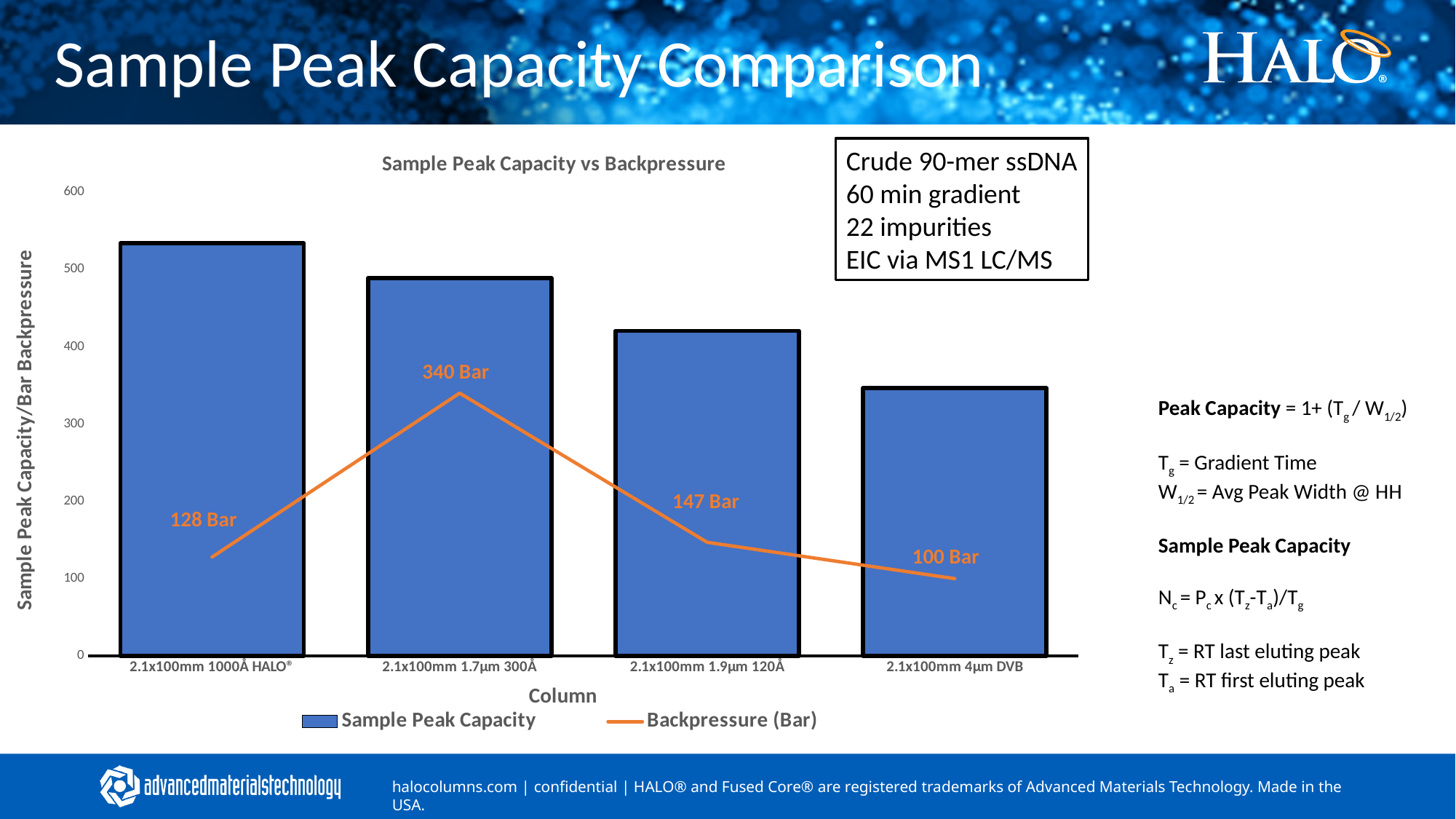
How many series does the chart legend list? 2 Which column has the highest backpressure? 2.1x100mm 1.7µm 300Å Which column has the highest sample peak capacity? 2.1x100mm 1000Å HALO What is the backpressure for the 2.1x100mm 1000Å HALO column? 128 Bar Is the sample peak capacity for the 2.1x100mm 1000Å HALO column greater or less than 500? greater What is the backpressure for the 2.1x100mm 4µm DVB column? 100 Bar Which column has the lowest sample peak capacity? 2.1x100mm 4µm DVB What is the backpressure for the 2.1x100mm 1.7µm 300Å column? 340 Bar How many columns are compared on the x axis of the chart? 4 Is the sample peak capacity for the 2.1x100mm 4µm DVB column greater or less than 400? less What is the difference in backpressure between the 2.1x100mm 1.7µm 300Å column and the 2.1x100mm 1000Å HALO column? 212 Bar Which column has the lowest backpressure? 2.1x100mm 4µm DVB